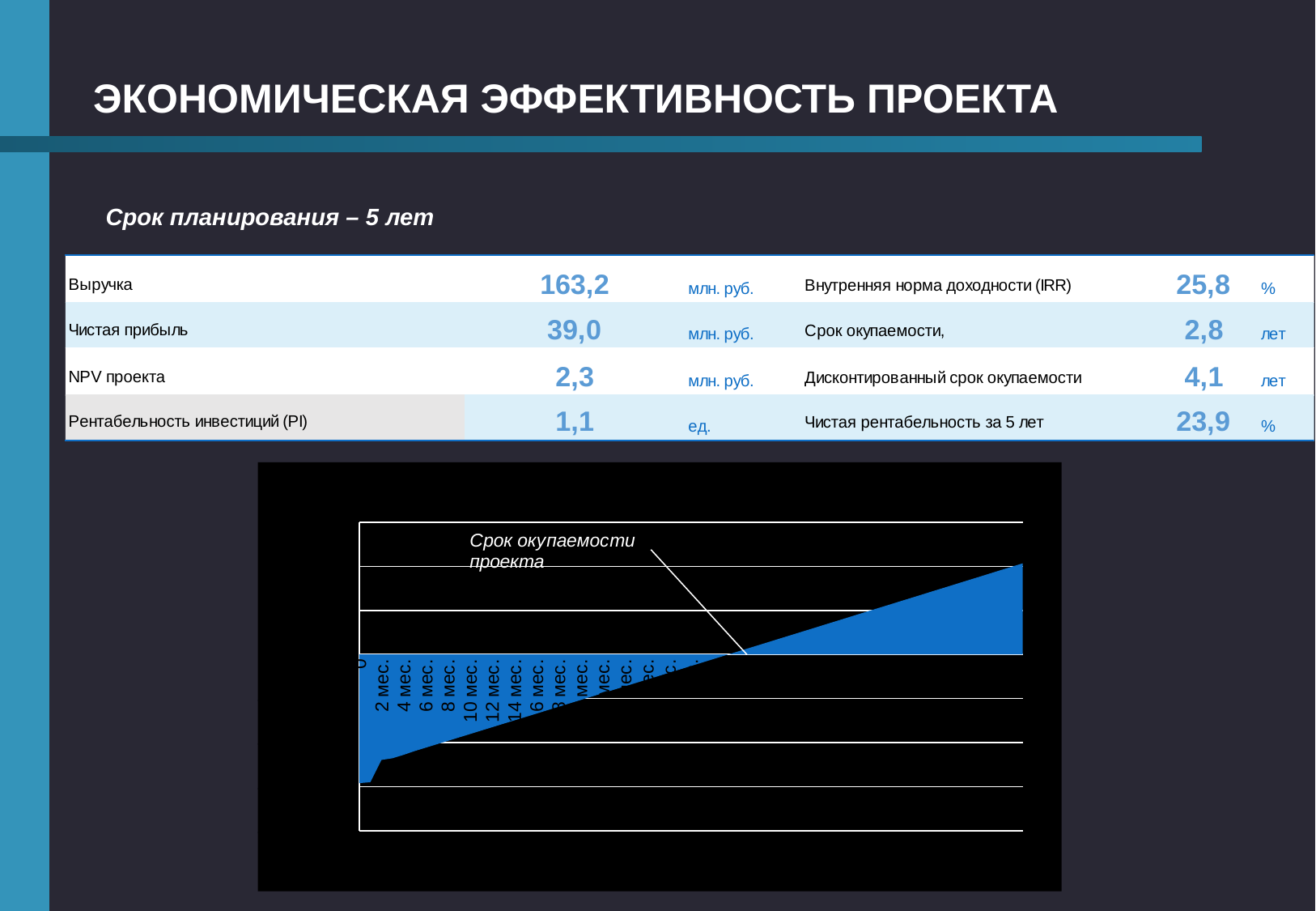
What annotation text is written inside the chart? Срок окупаемости проекта What kind of chart is shown on the slide? area chart Do the plotted values rise or fall along the x axis of the chart? rise In what unit are the x-axis categories of the chart labelled? мес. What colour is the filled area in the chart? blue